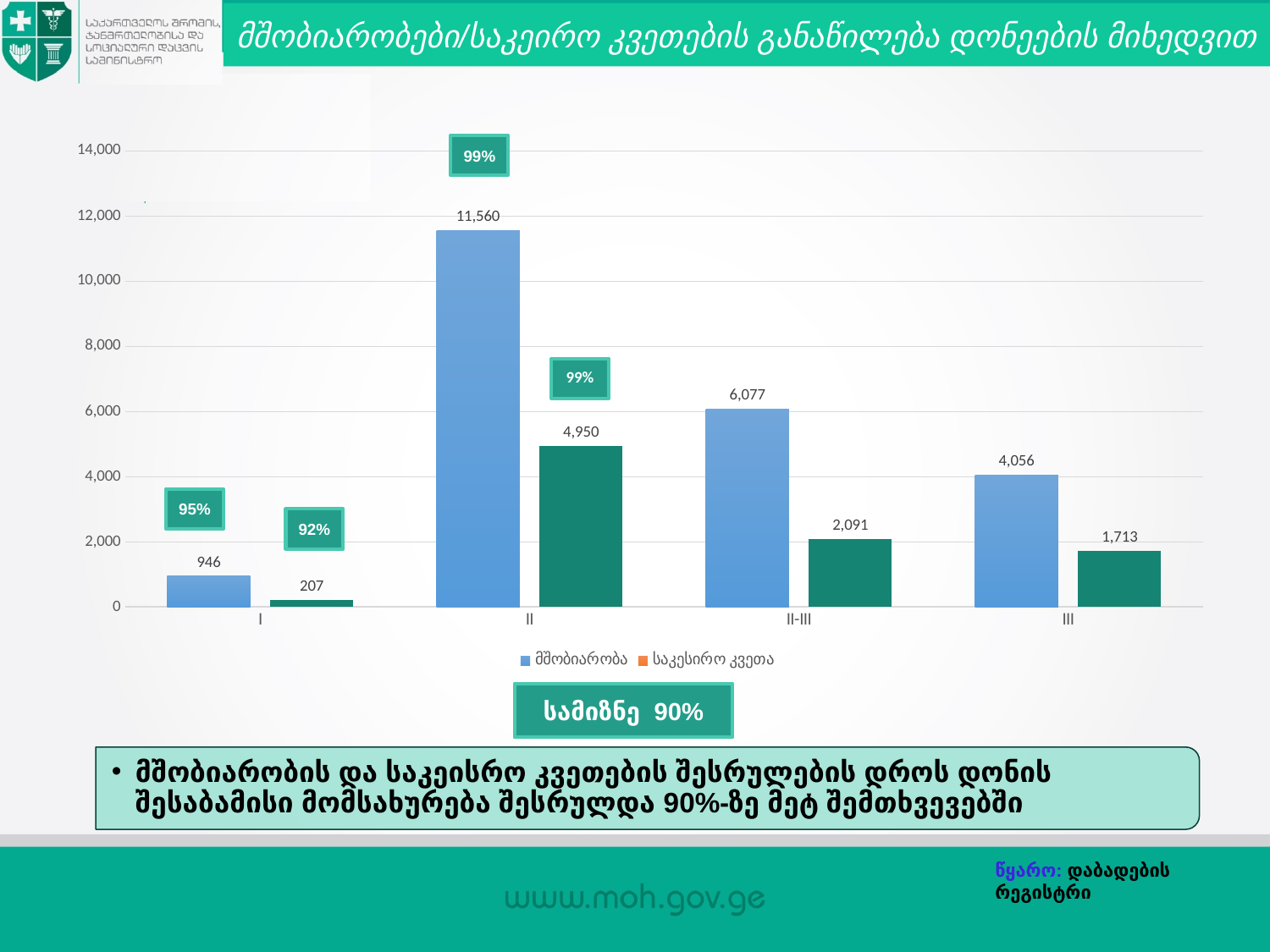
What is the value for მშობიარობა at level III? 4,056 What is the difference between მშობიარობა and საკესირო კვეთა at level II? 6,610 What percentage label is shown above the მშობიარობა bar at level I? 95% Which level has the highest value for მშობიარობა? II What kind of chart is shown on the slide? Bar chart What is the value for საკესირო კვეთა at level I? 207 Which level has the lowest value for საკესირო კვეთა? I What is the value for მშობიარობა at level II? 11,560 Which is larger: მშობიარობა at level II-III or მშობიარობა at level III? მშობიარობა at level II-III How many series does the legend list? 2 How many levels (categories) are shown on the x axis? 4 What is the value for საკესირო კვეთა at level II-III? 2,091